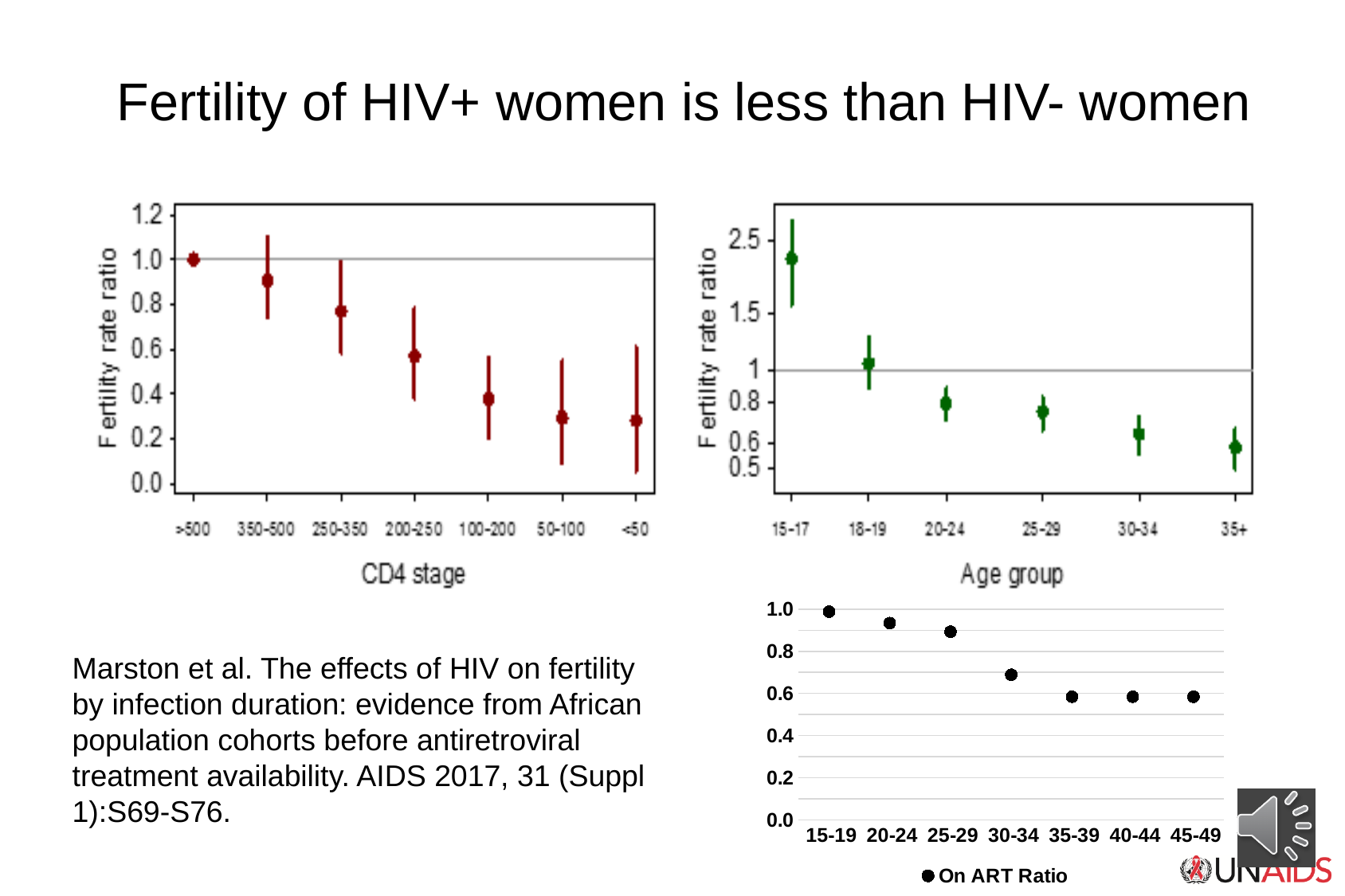
In the chart with Age group on the x axis, is the fertility rate ratio for the 30-34 age group greater or less than 0.8? less In the chart with CD4 stage on the x axis, how many CD4 stage categories are plotted? 7 In the chart with CD4 stage on the x axis, which CD4 stage has the highest fertility rate ratio? >500 In the chart with CD4 stage on the x axis, is the fertility rate ratio for the 350-500 CD4 stage greater or less than 0.8? greater In the chart with CD4 stage on the x axis, does the fertility rate ratio rise or fall as CD4 stage moves from >500 to <50? fall In the chart with CD4 stage on the x axis, what is the fertility rate ratio for the >500 CD4 stage? 1.0 In the On ART Ratio chart at the bottom right, how many age groups are plotted? 7 In the On ART Ratio chart at the bottom right, how many series does the legend list? 1 In the chart with CD4 stage on the x axis, which has the larger fertility rate ratio, the 350-500 stage or the 200-250 stage? 350-500 In the chart with CD4 stage on the x axis, is the fertility rate ratio for the 50-100 CD4 stage greater or less than 0.4? less In the chart with Age group on the x axis, which age group has the highest fertility rate ratio? 15-17